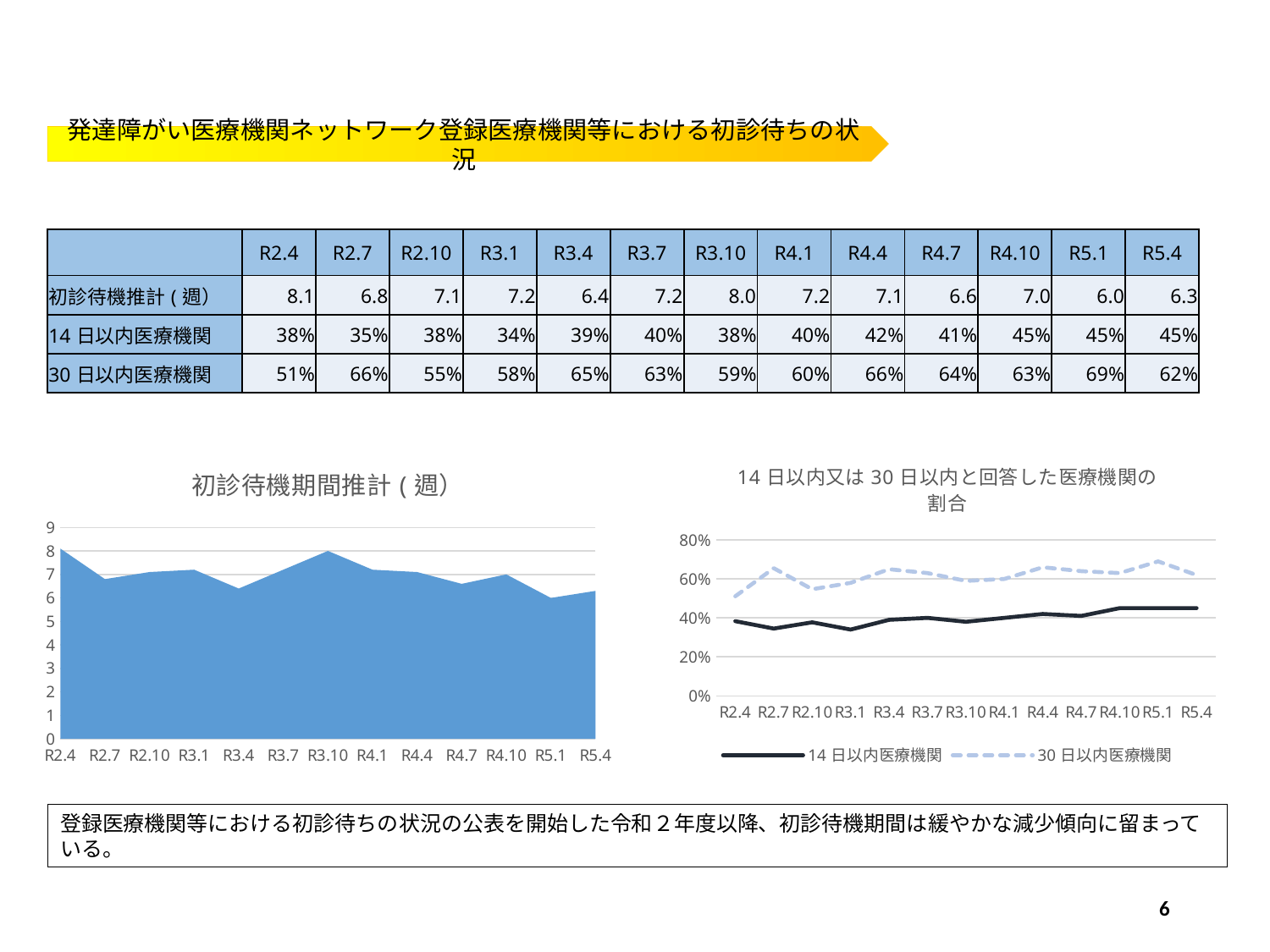
In the left chart 初診待機期間推計(週), which time point has the lowest value? R5.1 How many series does the legend of the right chart list? 2 In the right chart, is the value of 30日以内医療機関 at R2.4 greater or less than 60%? less In the right chart, what is the value of 30日以内医療機関 at R5.1? 69% What kind of chart is the right chart titled 14日以内又は30日以内と回答した医療機関の割合? Line chart What kind of chart is the left chart titled 初診待機期間推計(週)? Area chart In the right chart, at which time point does 30日以内医療機関 reach its highest value? R5.1 How many time points are shown on the x axis of the left chart 初診待機期間推計(週)? 13 In the right chart, what is the difference between the 30日以内医療機関 values at R2.7 and R2.4? 15 percentage points In the right chart, which series is larger at R2.7, 14日以内医療機関 or 30日以内医療機関? 30日以内医療機関 In the left chart 初診待機期間推計(週), what is the value for R3.10? 8.0 In the right chart, what is the value of 14日以内医療機関 at R5.4? 45%